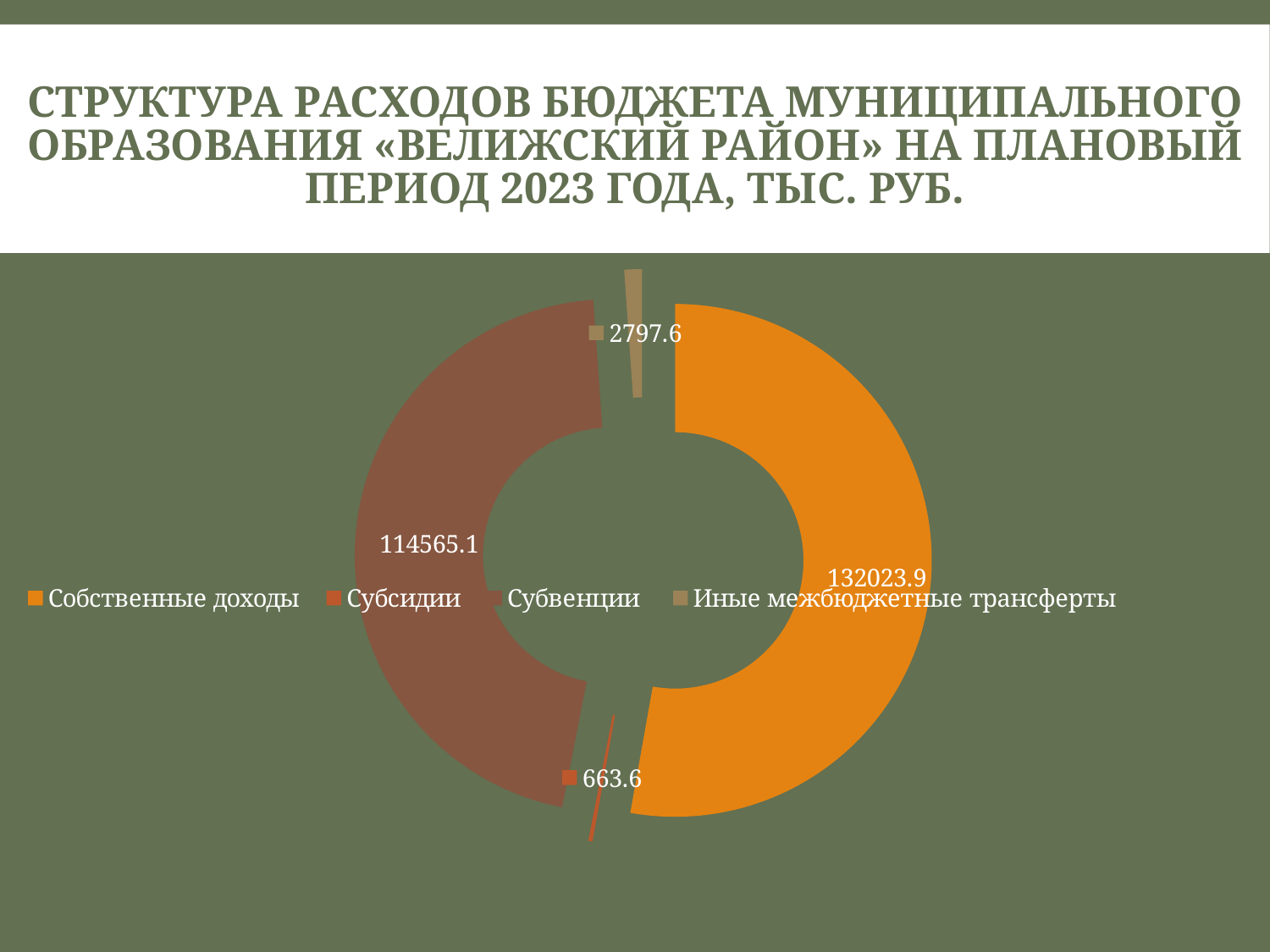
Which category has the largest value? Собственные доходы Which category has the smallest value? Субсидии Which is larger, Иные межбюджетные трансферты or Субсидии? Иные межбюджетные трансферты What is the value for Субвенции? 114565.1 How many entries does the legend list? 4 What type of chart is shown on the slide? Doughnut (pie) chart What is the value for Иные межбюджетные трансферты? 2797.6 How many categories does the chart show? 4 What is the value for Субсидии? 663.6 What is the difference between Собственные доходы and Субвенции? 17458.8 What colour is the Собственные доходы segment? Orange What is the value for Собственные доходы? 132023.9